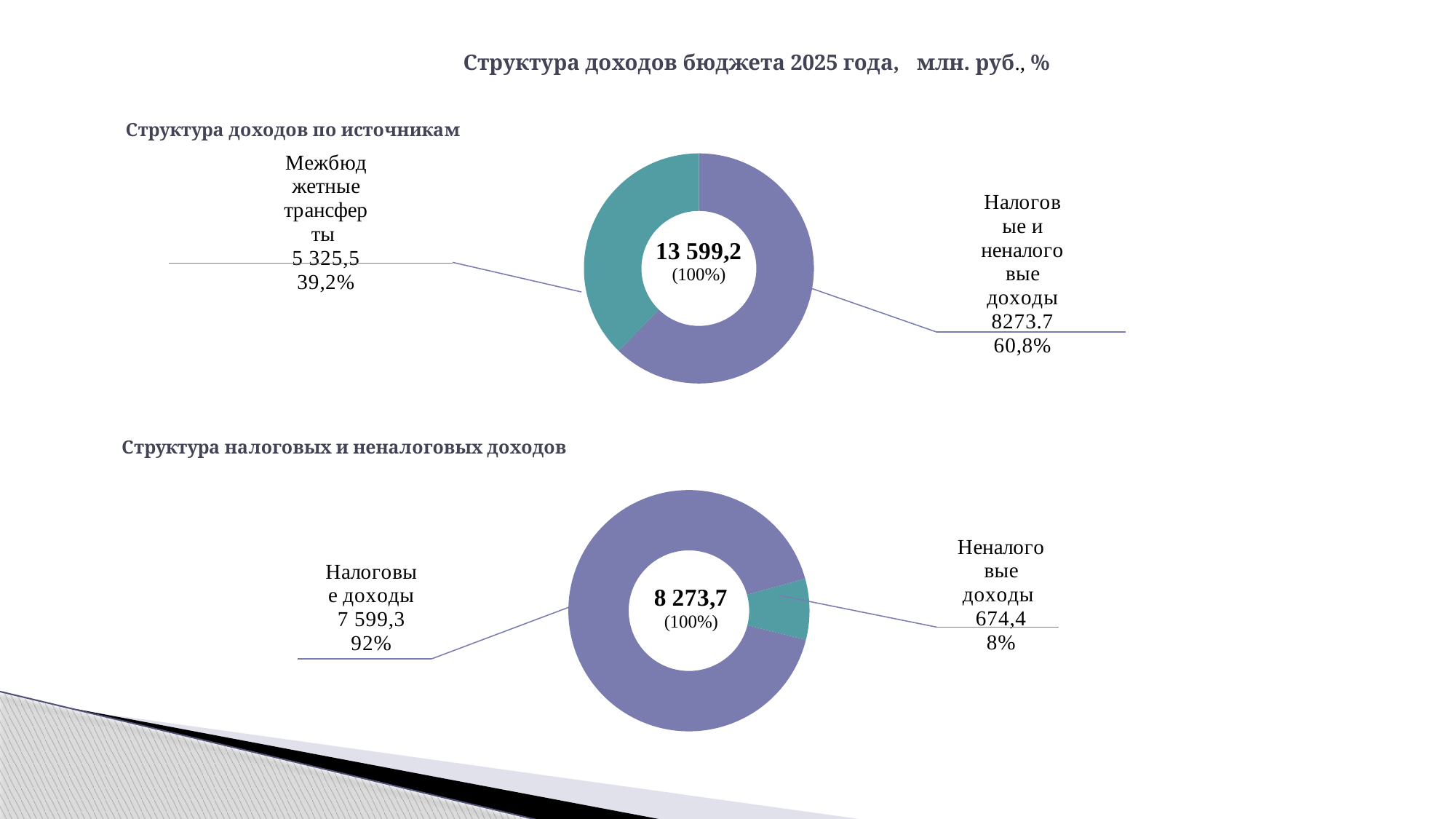
What kind of chart is used for 'Структура налоговых и неналоговых доходов'? Donut (pie) chart In the chart 'Структура налоговых и неналоговых доходов', what is the total shown in the centre of the donut? 8 273,7 In the chart 'Структура налоговых и неналоговых доходов', what share of the total do Налоговые доходы make up? 92% In the chart 'Структура доходов по источникам', what share of the total do Налоговые и неналоговые доходы make up? 60,8% In the chart 'Структура доходов по источникам', which category is the largest? Налоговые и неналоговые доходы In the chart 'Структура доходов по источникам', what is the total shown in the centre of the donut? 13 599,2 In the chart 'Структура доходов по источникам', what is the value for Межбюджетные трансферты? 5 325,5 How many categories does the chart 'Структура доходов по источникам' show? 2 In the chart 'Структура доходов по источникам', what share of the total do Межбюджетные трансферты make up? 39,2% In the chart 'Структура налоговых и неналоговых доходов', what is the value for Неналоговые доходы? 674,4 In the chart 'Структура налоговых и неналоговых доходов', what is the value for Налоговые доходы? 7 599,3 In the chart 'Структура налоговых и неналоговых доходов', which category is the smallest? Неналоговые доходы